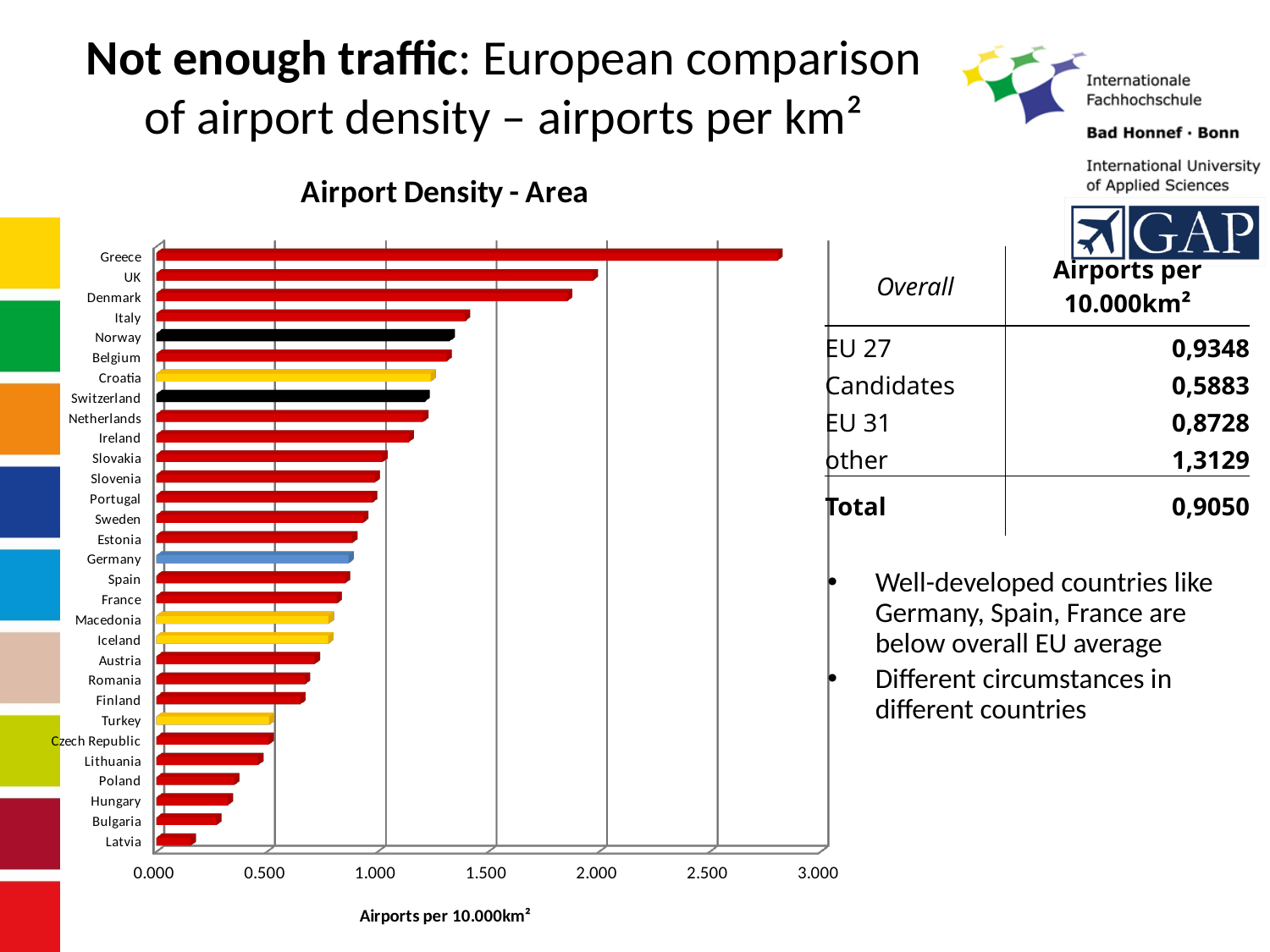
What is the label on the horizontal axis of the chart? Airports per 10.000km² Is the value for Latvia greater or less than 0.500? less What type of chart is shown on the slide? bar chart Which country has the highest airport density in the chart? Greece Is the value for UK greater or less than 1.500? greater Which has a higher airport density, Denmark or Italy? Denmark Is the value for Greece greater or less than 2.500? greater Which country has the lowest airport density in the chart? Latvia What is the title of the chart? Airport Density - Area Do the bar values increase or decrease going from the top of the chart to the bottom? decrease How many countries are shown in the chart? 30